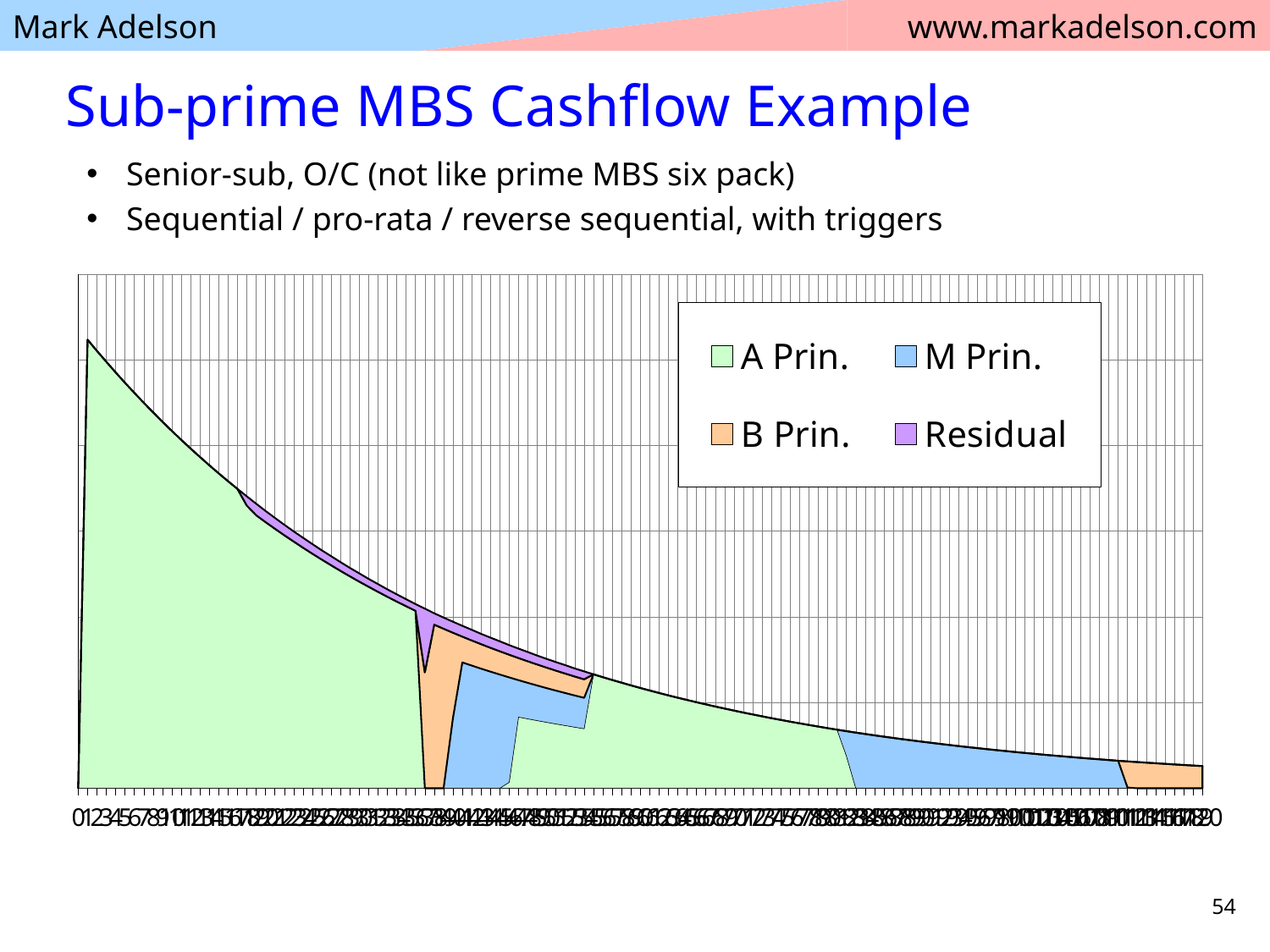
Does the total plotted cashflow rise or fall as you move from left to right along the x axis? Fall What are the series names listed in the chart's legend? A Prin., M Prin., B Prin., Residual How many series does the chart's legend list? 4 Which series occupies the smallest area in the chart? Residual Which series has a larger area in the chart, M Prin. or Residual? M Prin. Which series has a larger area in the chart, A Prin. or Residual? A Prin. What colour is used for the A Prin. series in the chart? Green What kind of chart is shown on the slide? Area chart Which series occupies the largest area in the chart? A Prin.